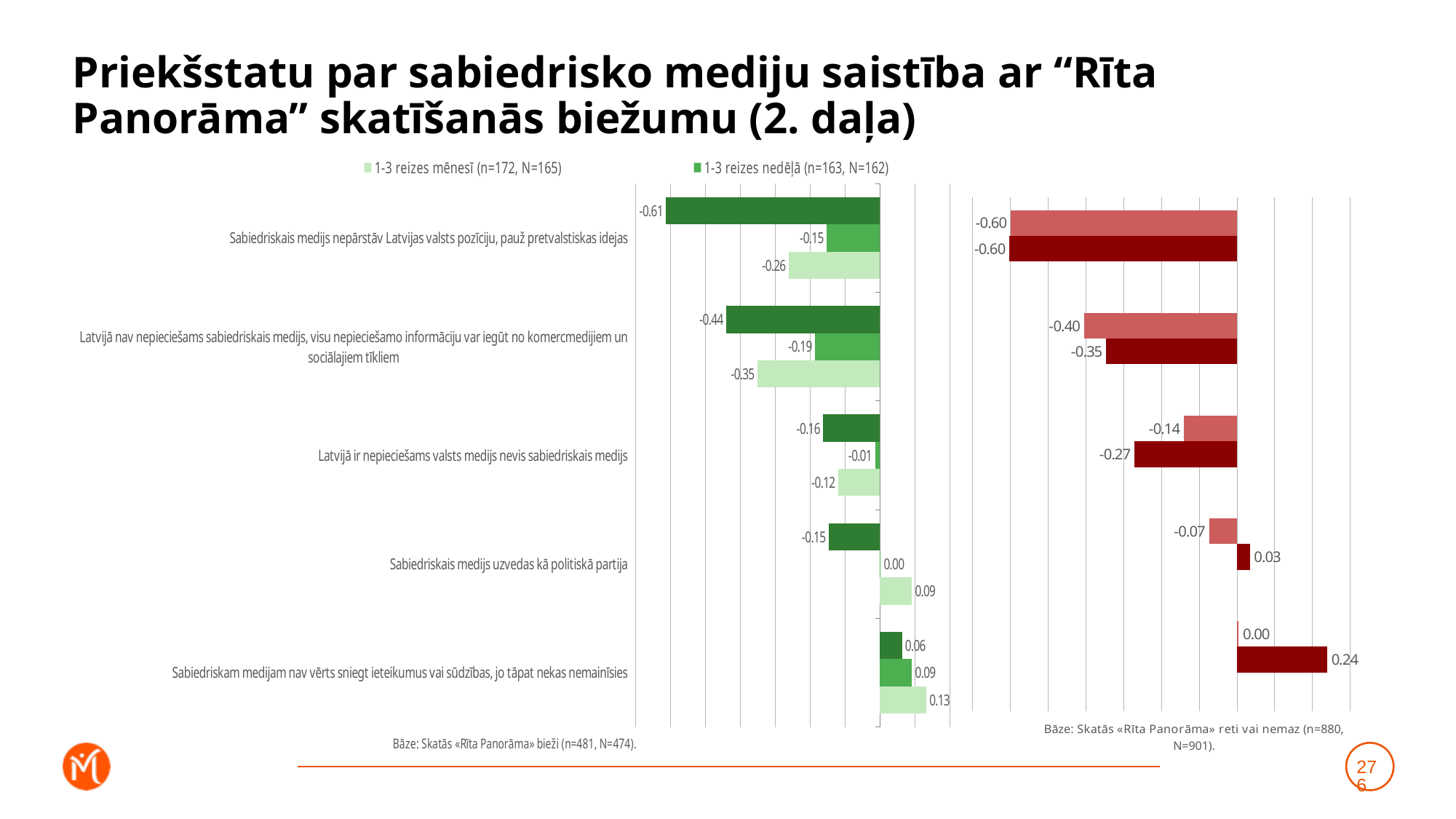
On the left chart, what is the value of the '1-3 reizes mēnesī' series for 'Sabiedriskais medijs nepārstāv Latvijas valsts pozīciju, pauž pretvalstiskas idejas'? -0.26 On the left chart, which statement has the highest value in the '1-3 reizes nedēļā' series? Sabiedriskam medijam nav vērts sniegt ieteikumus vai sūdzības, jo tāpat nekas nemainīsies On the right chart, which is larger for 'Latvijā ir nepieciešams valsts medijs nevis sabiedriskais medijs': the lighter red bar (-0.14) or the darker red bar (-0.27)? The lighter red bar (-0.14) On the left chart, what is the value of the '1-3 reizes nedēļā' series for 'Latvijā nav nepieciešams sabiedriskais medijs, visu nepieciešamo informāciju var iegūt no komercmedijiem un sociālajiem tīkliem'? -0.19 What type of chart is used on the left side of the slide? Bar chart On the left chart, what is the difference between the '1-3 reizes mēnesī' value (-0.35) and the '1-3 reizes nedēļā' value (-0.19) for 'Latvijā nav nepieciešams sabiedriskais medijs...'? 0.16 On the right chart, what is the value of the darker red bar for 'Sabiedriskam medijam nav vērts sniegt ieteikumus vai sūdzības, jo tāpat nekas nemainīsies'? 0.24 On the left chart, what is the value of the '1-3 reizes mēnesī' series for 'Sabiedriskam medijam nav vērts sniegt ieteikumus vai sūdzības, jo tāpat nekas nemainīsies'? 0.13 How many statements (categories) are shown on the left chart? 5 On the right chart, what is the value of the lighter red bar for 'Latvijā ir nepieciešams valsts medijs nevis sabiedriskais medijs'? -0.14 On the left chart, which statement has the lowest value in the '1-3 reizes mēnesī' series? Latvijā nav nepieciešams sabiedriskais medijs, visu nepieciešamo informāciju var iegūt no komercmedijiem un sociālajiem tīkliem How many series does the legend at the top of the slide list? 2